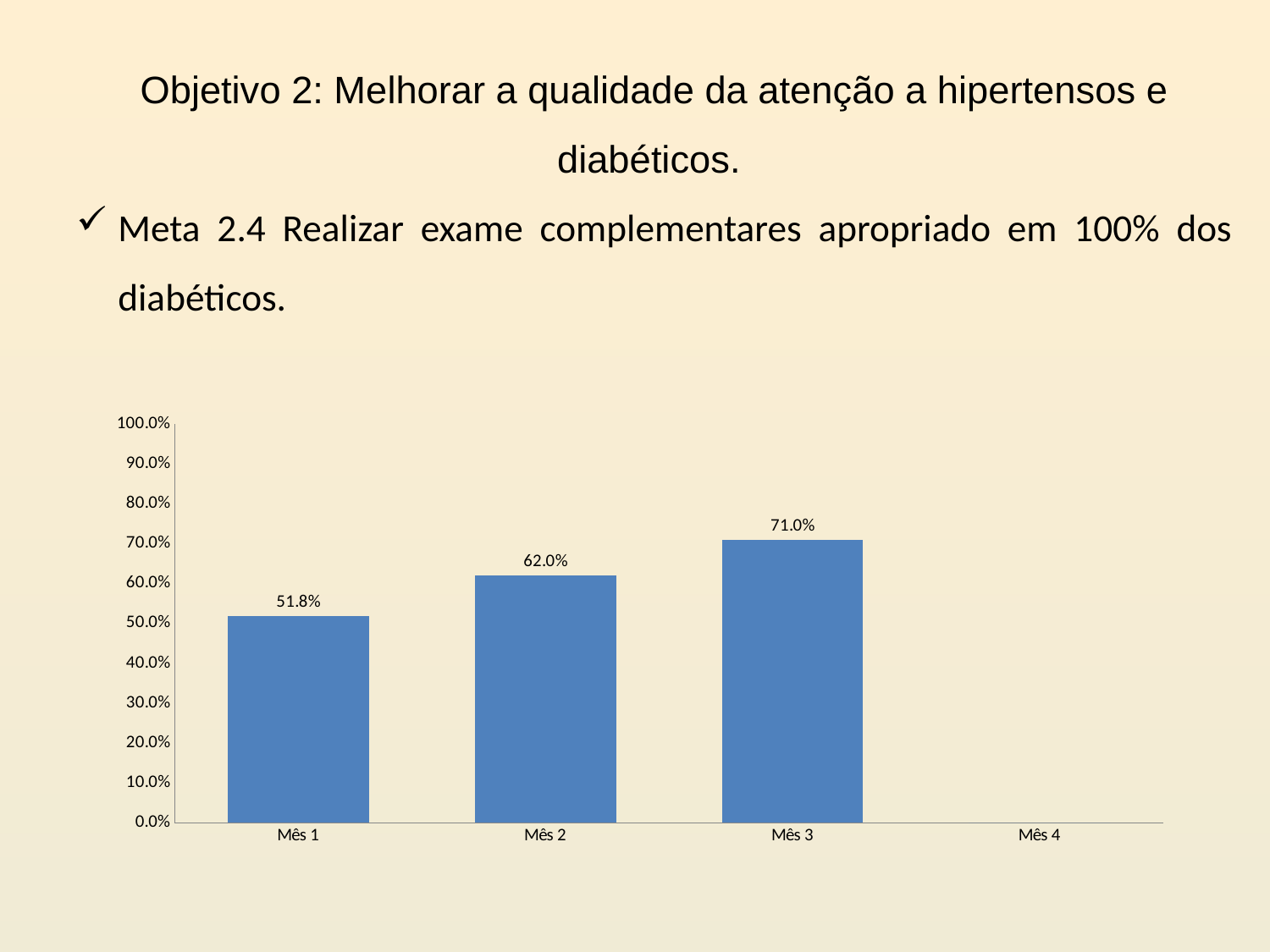
What is the difference between the values for Mês 2 and Mês 1? 10.2% What is the value for Mês 2? 62.0% What is the difference between the values for Mês 3 and Mês 1? 19.2% Among the months with a plotted bar, which has the lowest value? Mês 1 Which month has the highest value? Mês 3 Which is larger, the value for Mês 2 or the value for Mês 3? Mês 3 What is the value for Mês 3? 71.0% How many categories are shown on the x axis? 4 What is the value for Mês 1? 51.8% Is the value for Mês 2 greater or less than 60.0%? greater Do the values rise or fall from Mês 1 to Mês 3? rise What kind of chart is shown on the slide? bar chart